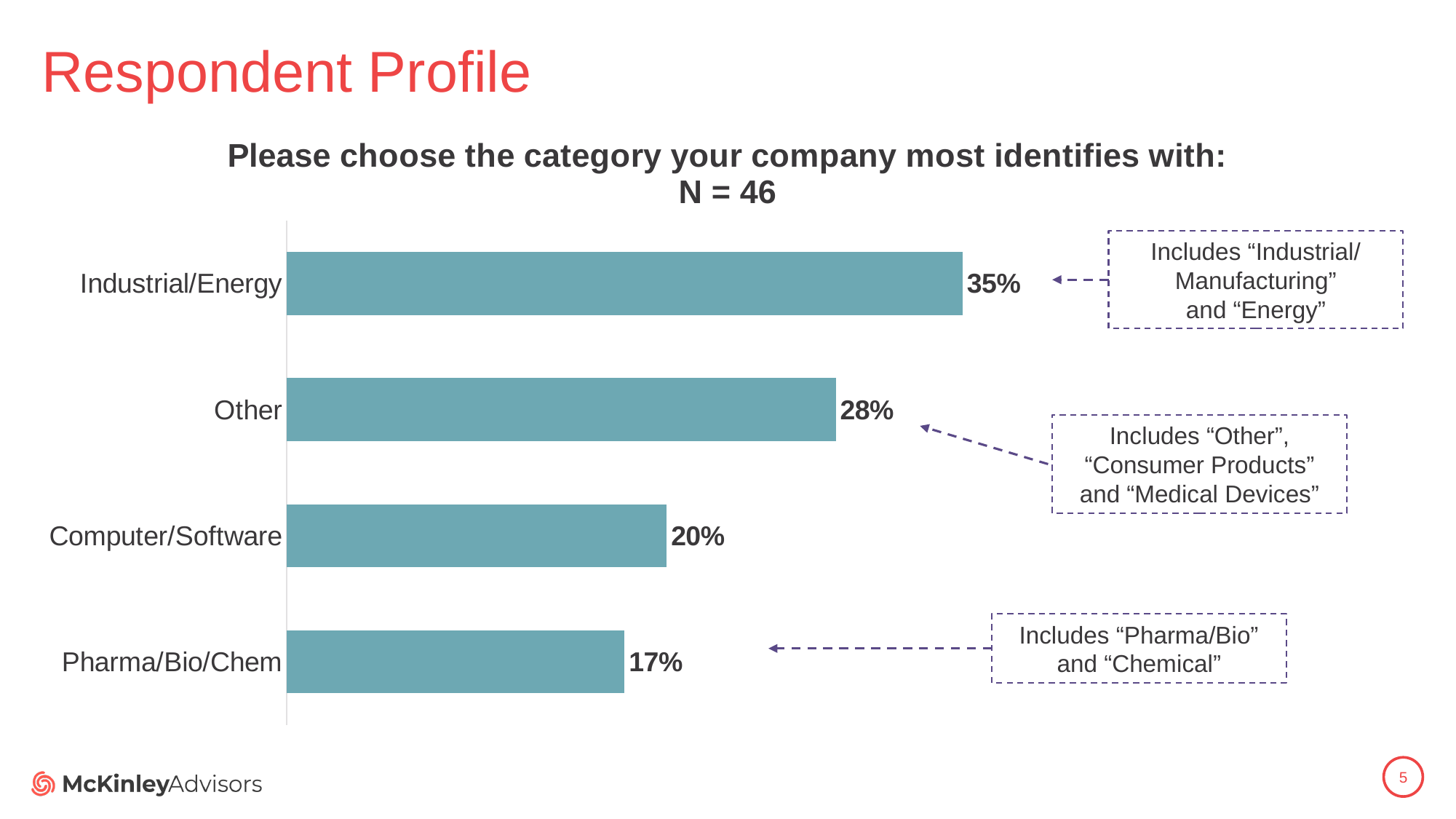
What percentage of respondents chose Other? 28% What percentage of respondents chose Computer/Software? 20% Which category has the highest share of respondents? Industrial/Energy What is the difference in percentage points between Industrial/Energy and Other? 7 percentage points What percentage of respondents chose Pharma/Bio/Chem? 17% What kind of chart is shown on the slide? Bar chart Which is larger, the share for Other or the share for Computer/Software? Other What percentage of respondents chose Industrial/Energy? 35% How many categories are shown in the chart? 4 Which category has the lowest share of respondents? Pharma/Bio/Chem What is the difference in percentage points between Computer/Software and Pharma/Bio/Chem? 3 percentage points What is the sample size (N) stated in the chart title? 46